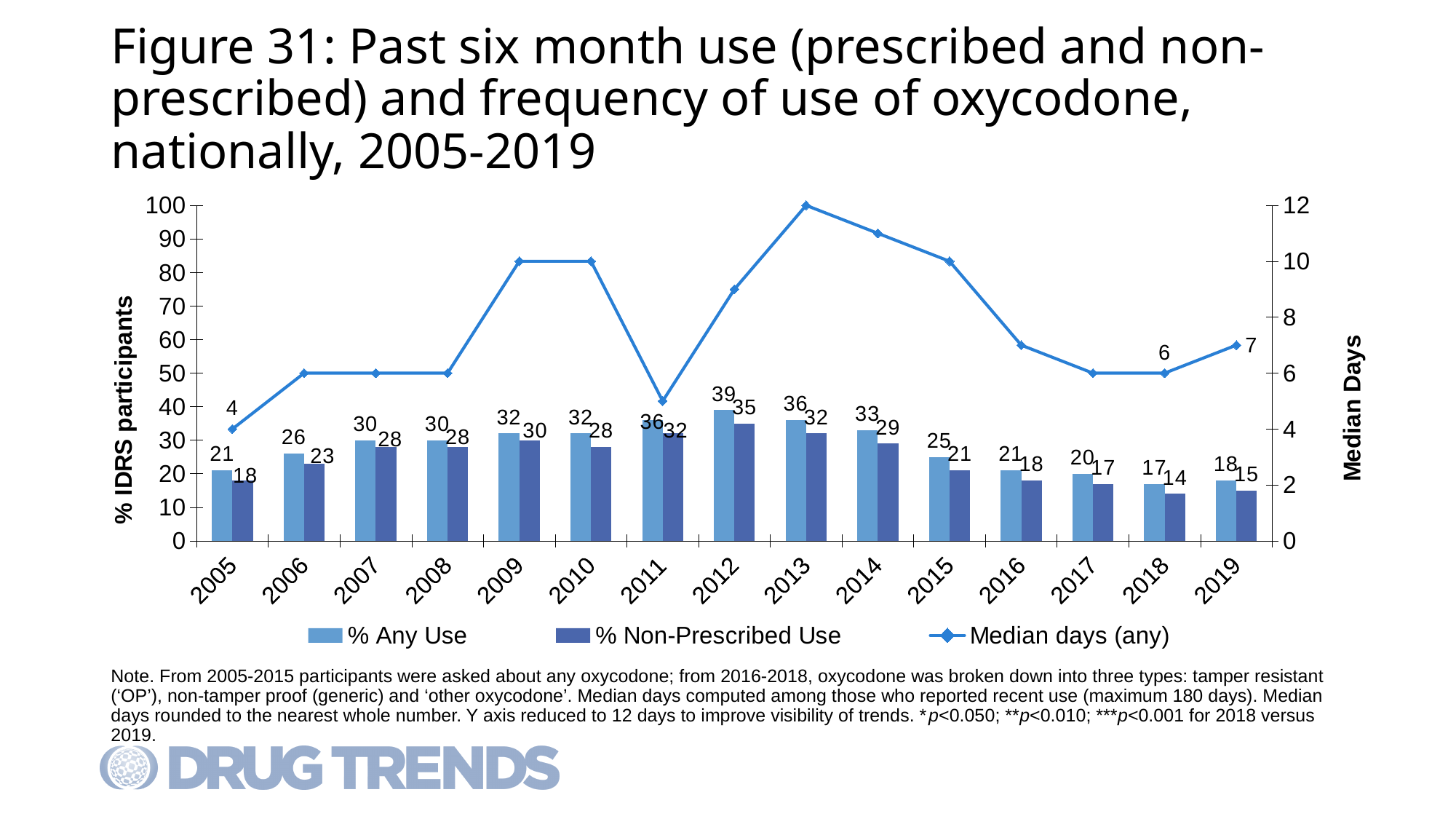
What kind of chart is this? Combined bar and line chart Which year has the lowest % Non-Prescribed Use? 2018 Which year has the larger % Any Use, 2007 or 2014? 2014 Is the Median days (any) value for 2013 greater or less than 10? greater How many years are shown on the x axis? 15 What is the Median days (any) value for 2019? 7 Does % Any Use rise or fall from 2012 to 2018? Fall What is the difference between % Any Use and % Non-Prescribed Use in 2012? 4 What is the % Any Use value for 2012? 39 Which year has the highest % Any Use? 2012 What is the % Non-Prescribed Use value for 2018? 14 How many series does the legend list? 3